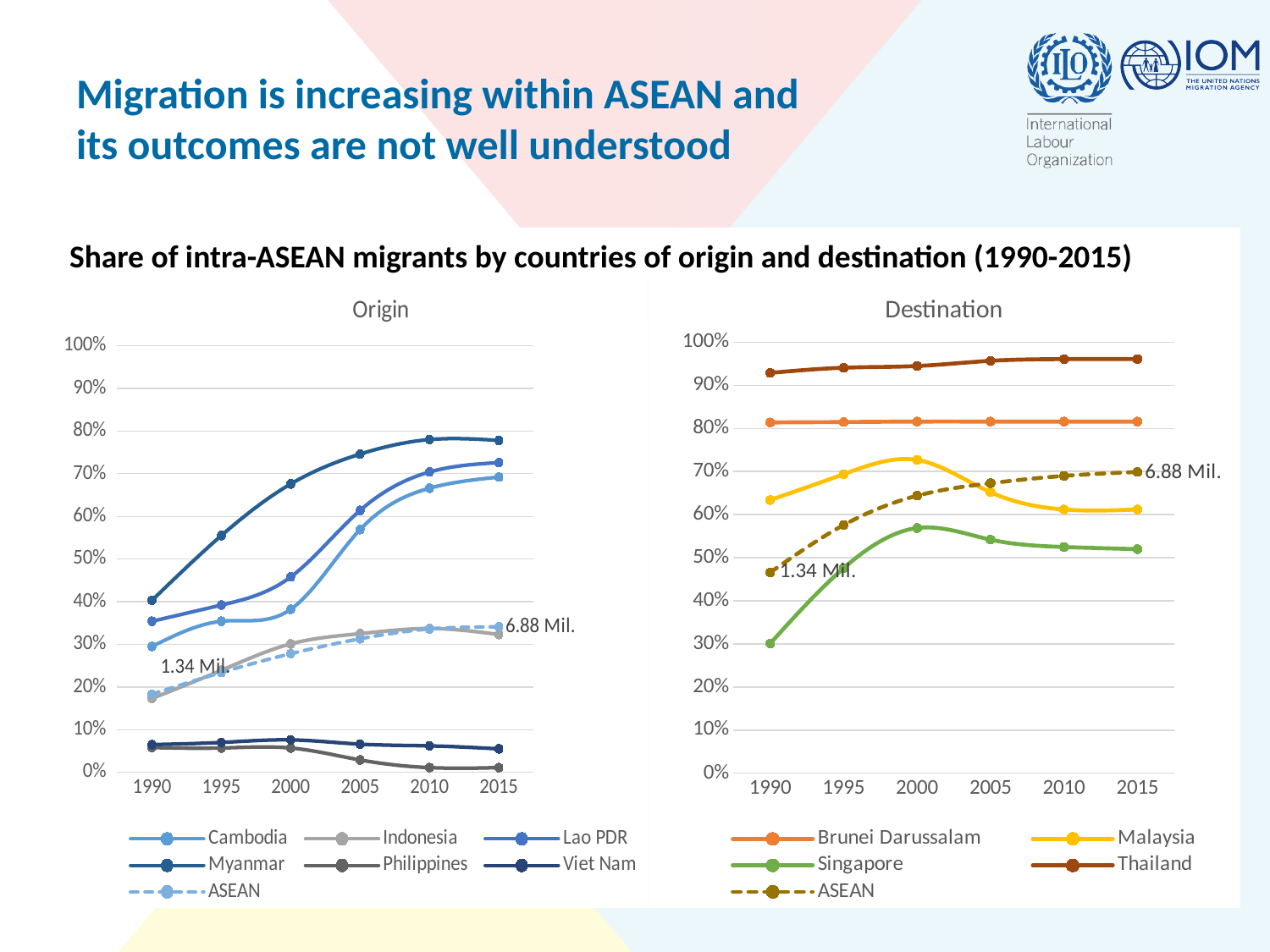
How many series does the legend of the Origin chart list? 7 What value is labelled at the 2015 end of the ASEAN line in the Destination chart? 6.88 Mil. How many series does the legend of the Destination chart list? 5 In the Origin chart, which country has the lowest share in 2015? Philippines In the Origin chart, does the share for Myanmar rise or fall from 1990 to 2015? rise How many years are plotted along the x axis of the Destination chart? 6 In the Destination chart, which country has the highest share in 2015? Thailand In the Origin chart, is the value for Myanmar in 2015 greater or less than 70%? greater What kind of chart is the Origin chart? line chart In the Destination chart, is the value for Singapore in 1990 greater or less than 40%? less In the Destination chart, which country has the lowest share in 1990? Singapore In the Origin chart, which country has the highest share in 2015? Myanmar